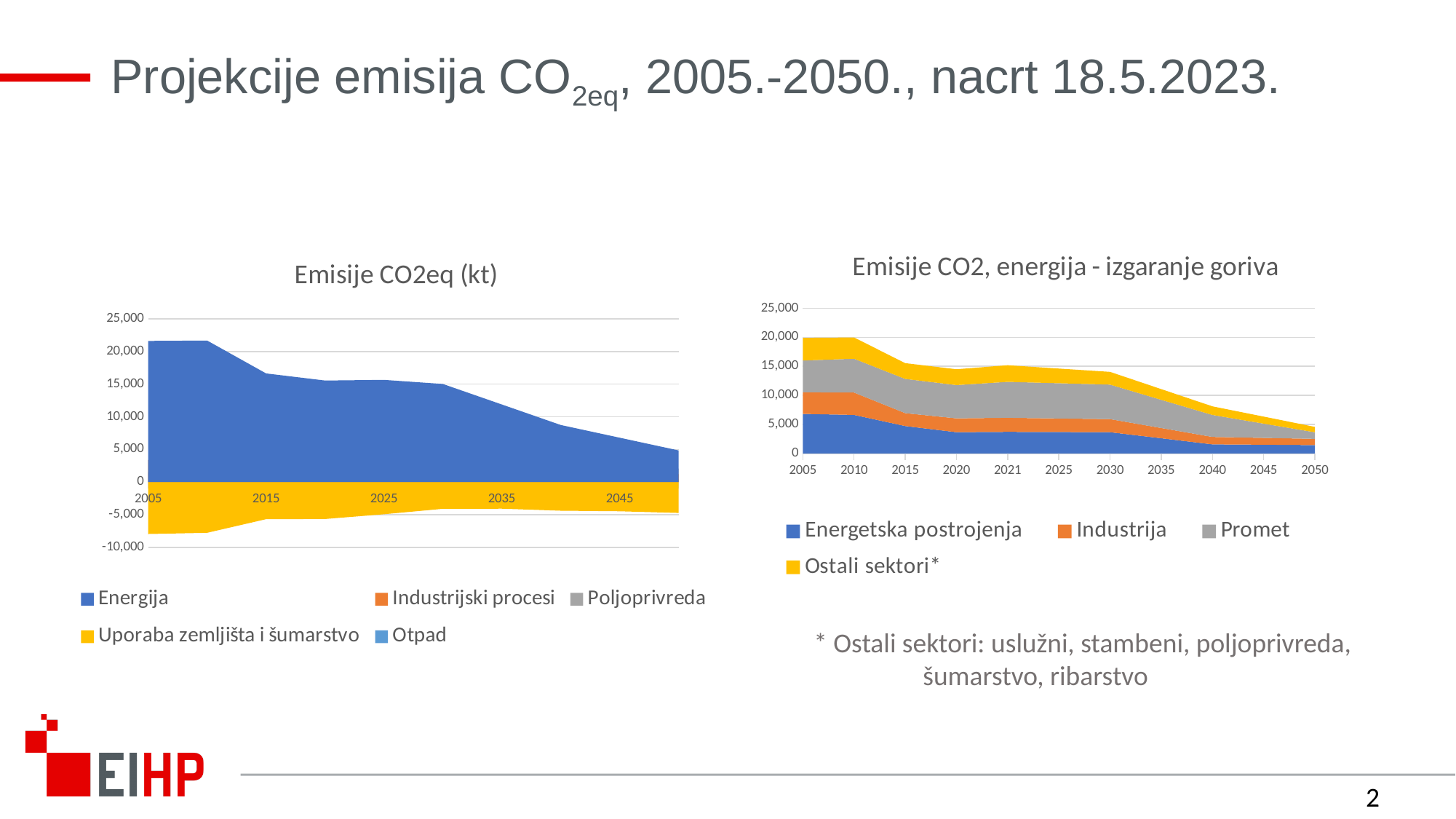
In the left chart "Emisije CO2eq (kt)", is the value for Uporaba zemljišta i šumarstvo in 2005 greater or less than -5,000? less How many years are labelled on the x axis of the right chart "Emisije CO2, energija - izgaranje goriva"? 11 In the right chart "Emisije CO2, energija - izgaranje goriva", does the total stacked emission rise or fall from 2005 to 2050? fall In the left chart "Emisije CO2eq (kt)", does the Energija series rise or fall from 2005 to 2050? fall Which series is shown in grey in the right chart "Emisije CO2, energija - izgaranje goriva"? Promet In the right chart "Emisije CO2, energija - izgaranje goriva", is the value for Energetska postrojenja in 2005 greater or less than 5,000? greater In the right chart "Emisije CO2, energija - izgaranje goriva", is the total stacked value in 2030 greater or less than 15,000? less What kind of chart is the left chart titled "Emisije CO2eq (kt)"? area chart How many series does the legend of the left chart "Emisije CO2eq (kt)" list? 5 How many series does the legend of the right chart "Emisije CO2, energija - izgaranje goriva" list? 4 What is the title of the left chart on the slide? Emisije CO2eq (kt)